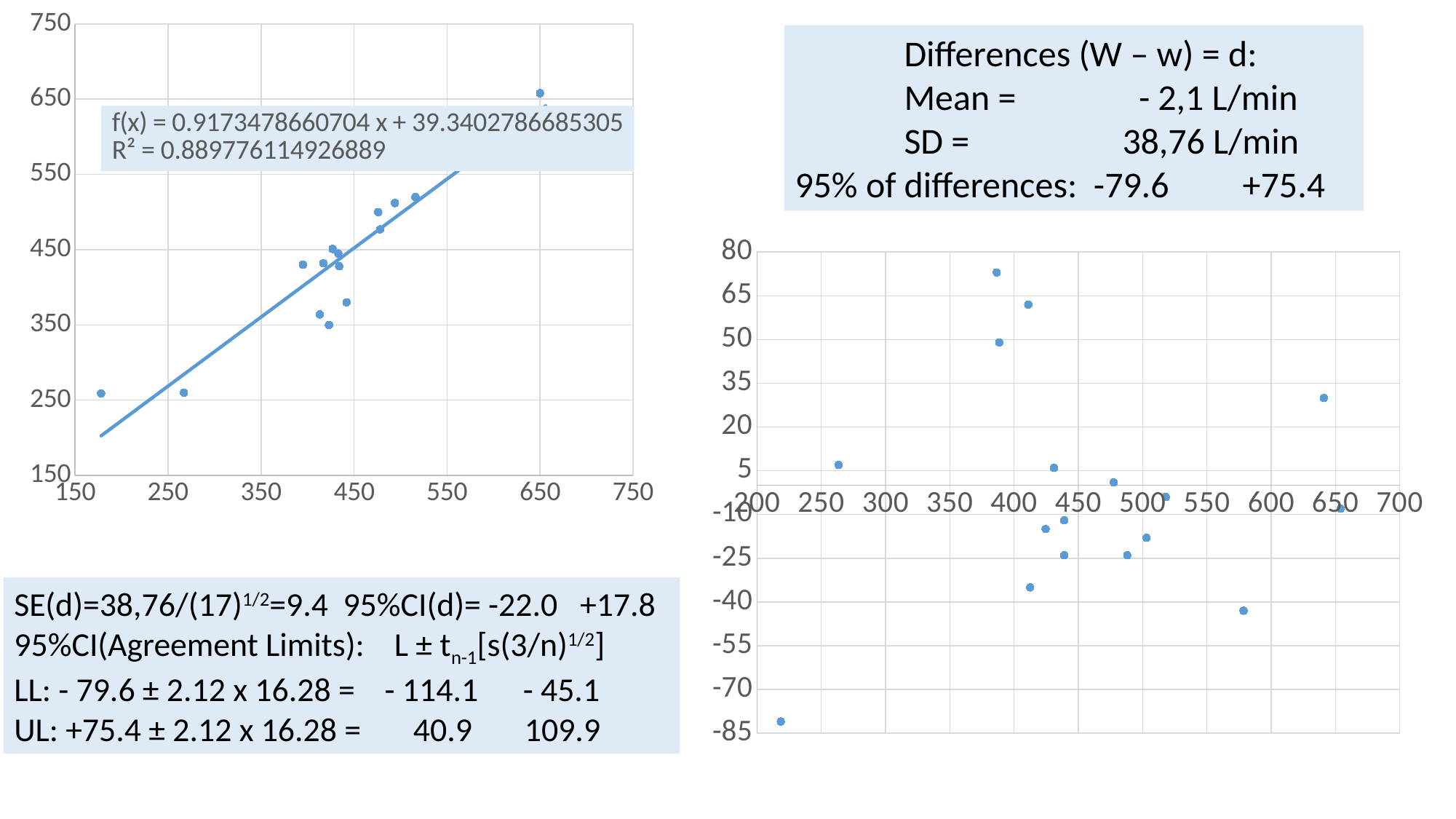
In the left chart, what is the trendline equation shown on the chart? f(x) = 0.9173478660704 x + 39.3402786685305 In the left chart, is the y value of the point with the largest x value greater or less than 550? greater In the right chart, is the y value of the point near x = 640 greater or less than 20? greater In the right chart, is the value of the highest point greater or less than 65? greater What kind of chart is the chart on the left of the slide? scatter chart In the left chart, what R² value is displayed? R² = 0.889776114926889 In the left chart, do the plotted points generally rise or fall as the x value increases? rise How many data points are plotted in the right chart? 17 What kind of chart is the chart on the right of the slide? scatter chart